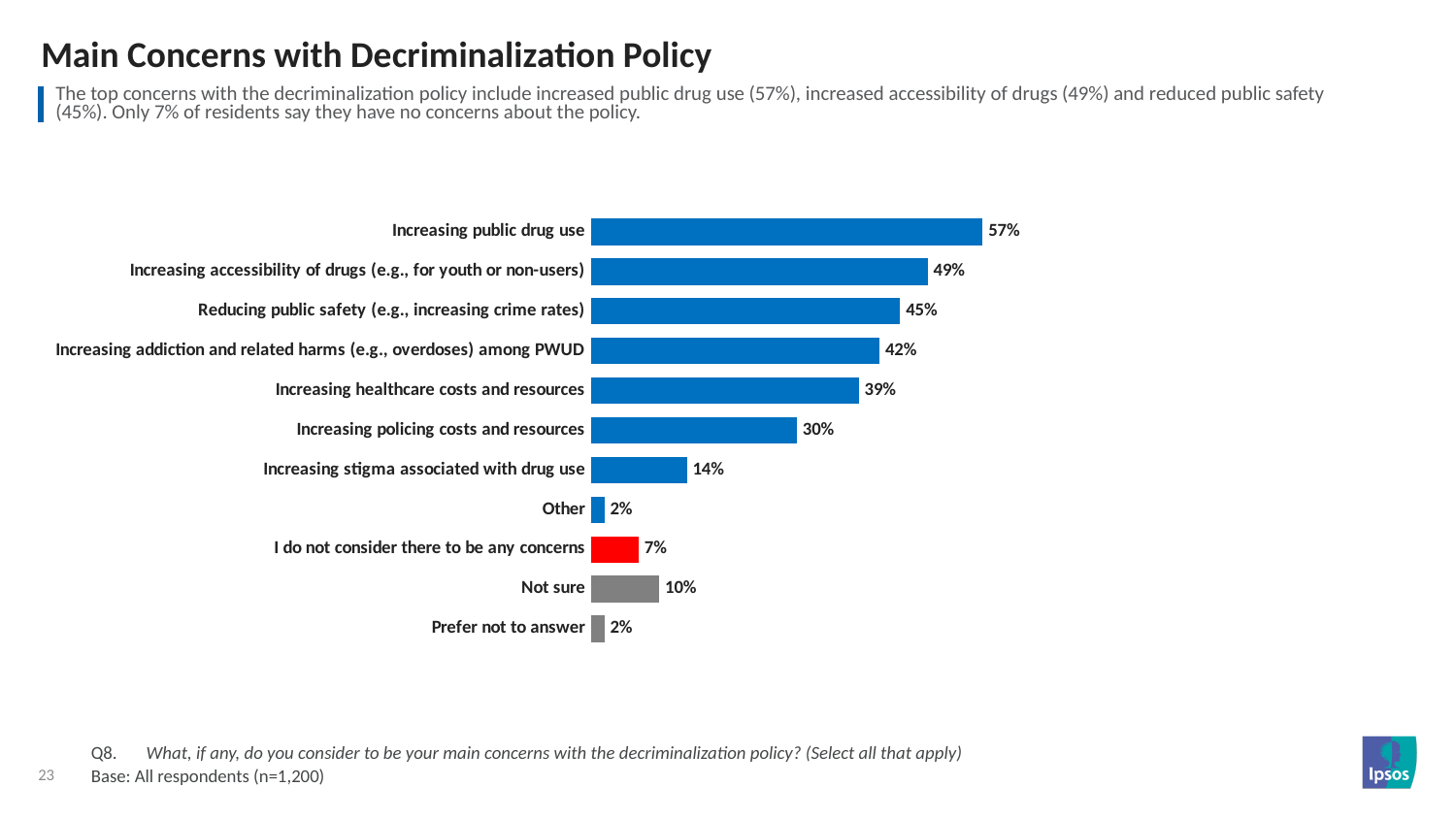
What is the value for 'Increasing healthcare costs and resources'? 39% What is the value for 'Not sure'? 10% What percentage of respondents said they do not consider there to be any concerns? 7% What is the difference between 'Increasing policing costs and resources' and 'Increasing stigma associated with drug use'? 16 percentage points Which category has the highest value in the chart? Increasing public drug use How many categories are shown in the chart? 11 What colour is the bar for 'I do not consider there to be any concerns'? Red What is the difference between 'Increasing public drug use' and 'Increasing accessibility of drugs (e.g., for youth or non-users)'? 8 percentage points What type of chart is shown on the slide? Bar chart What is the title of the slide? Main Concerns with Decriminalization Policy Which is larger: 'Reducing public safety (e.g., increasing crime rates)' or 'Increasing addiction and related harms (e.g., overdoses) among PWUD'? Reducing public safety (e.g., increasing crime rates) What percentage of respondents cited increasing public drug use as a concern? 57%